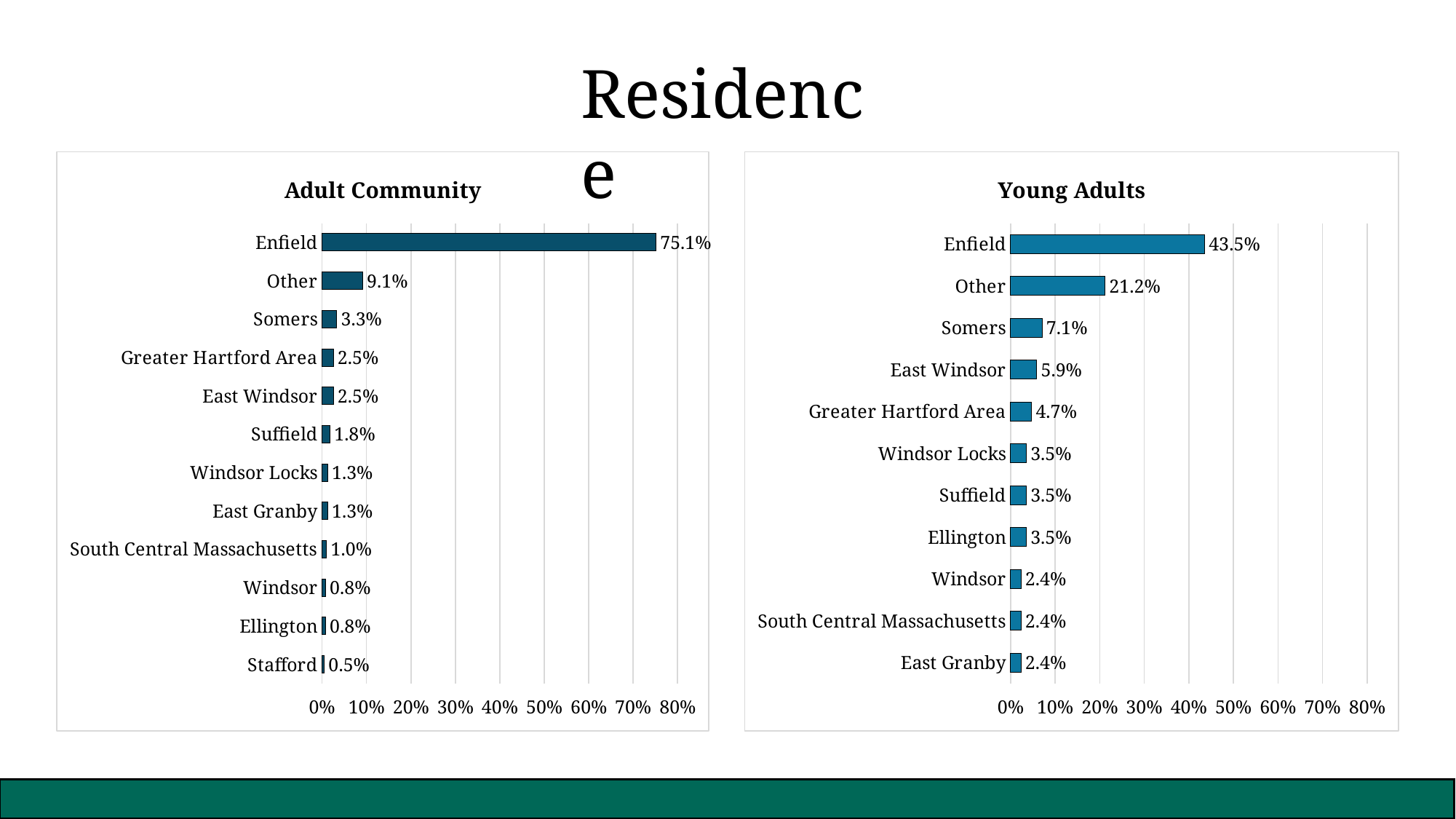
In the Young Adults chart, what is the value for Other? 21.2% In the Adult Community chart, what is the difference between Enfield and Other? 66.0% In the Young Adults chart, what is the difference between Somers and East Windsor? 1.2% In the Adult Community chart, which category has the lowest value? Stafford What kind of chart is the Young Adults chart? bar chart In the Young Adults chart, which category has the highest value? Enfield How many categories are shown in the Adult Community chart? 12 Which is larger: Somers in the Adult Community chart or Somers in the Young Adults chart? Young Adults In the Young Adults chart, what is the value for Greater Hartford Area? 4.7% In the Adult Community chart, is the value for Enfield greater or less than 70%? greater In the Adult Community chart, what is the value for Enfield? 75.1% How many categories are shown in the Young Adults chart? 11